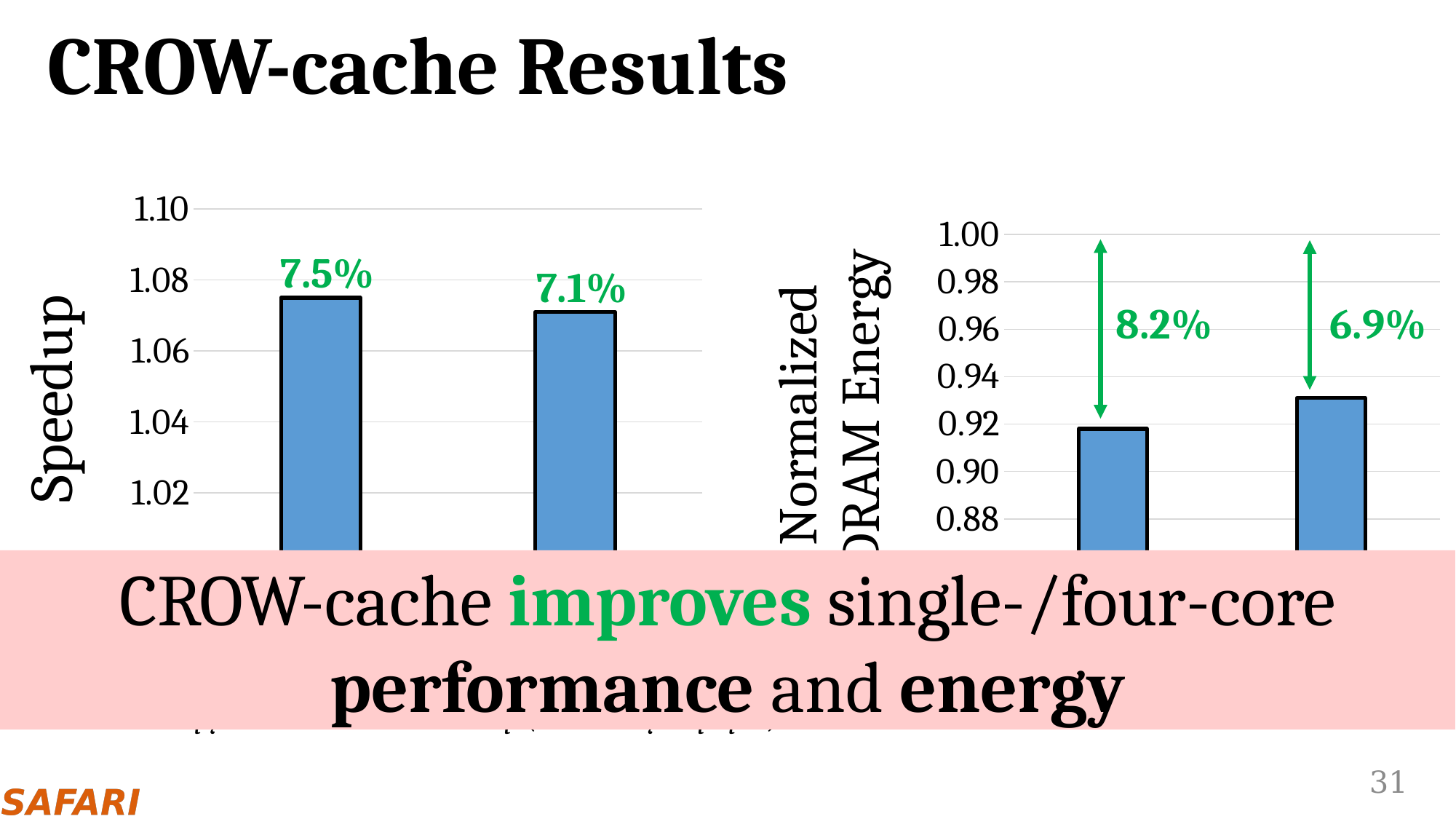
In the Speedup chart on the left, is the value of the right bar greater or less than 1.06? greater In the Normalized DRAM Energy chart on the right, which bar is lower, the left bar or the right bar? the left bar In the Speedup chart on the left, what percentage label is printed above the right bar? 7.1% In the Speedup chart on the left, what percentage label is printed above the left bar? 7.5% In the Normalized DRAM Energy chart on the right, what percentage is printed next to the arrow above the right bar? 6.9% What is the y-axis title of the chart on the right of the slide? Normalized DRAM Energy In the Speedup chart on the left, which bar has the higher percentage label, the left bar or the right bar? the left bar In the Normalized DRAM Energy chart on the right, what percentage is printed next to the arrow above the left bar? 8.2% How many bars are plotted in the Normalized DRAM Energy chart on the right? 2 What kind of chart is the Speedup chart on the left of the slide? bar chart In the Normalized DRAM Energy chart on the right, is the value of the left bar greater or less than 0.94? less How many bars are plotted in the Speedup chart on the left? 2